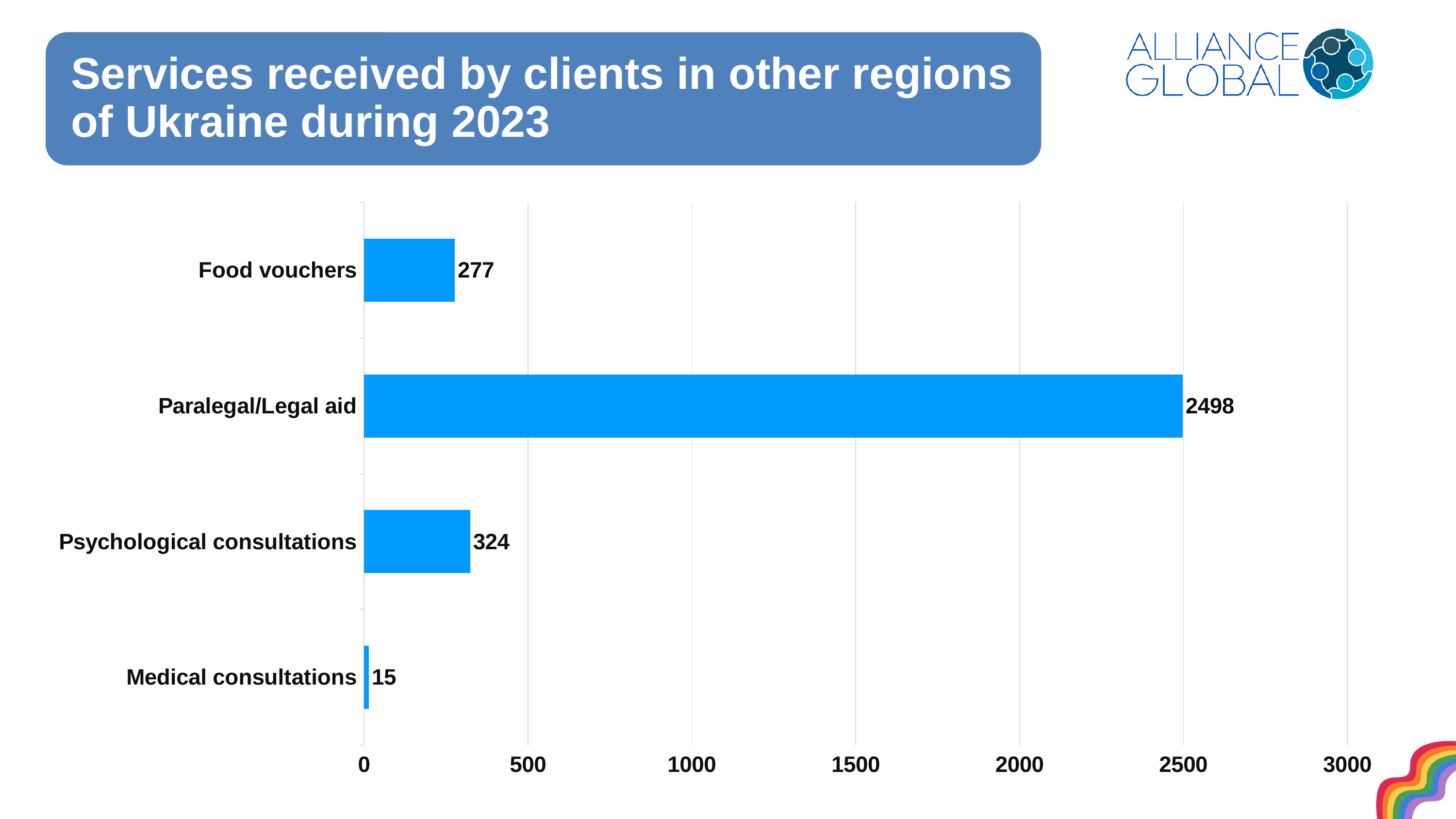
What is the difference between Paralegal/Legal aid and Medical consultations? 2483 Is the value for Paralegal/Legal aid greater or less than 2000? greater What is the difference between Psychological consultations and Food vouchers? 47 Which service has the highest value? Paralegal/Legal aid How many service categories are shown in the chart? 4 What is the value for Food vouchers? 277 What is the value for Medical consultations? 15 What kind of chart is shown on the slide? Bar chart Which service has the lowest value? Medical consultations Which is larger, Food vouchers or Psychological consultations? Psychological consultations What is the value for Paralegal/Legal aid? 2498 What is the value for Psychological consultations? 324